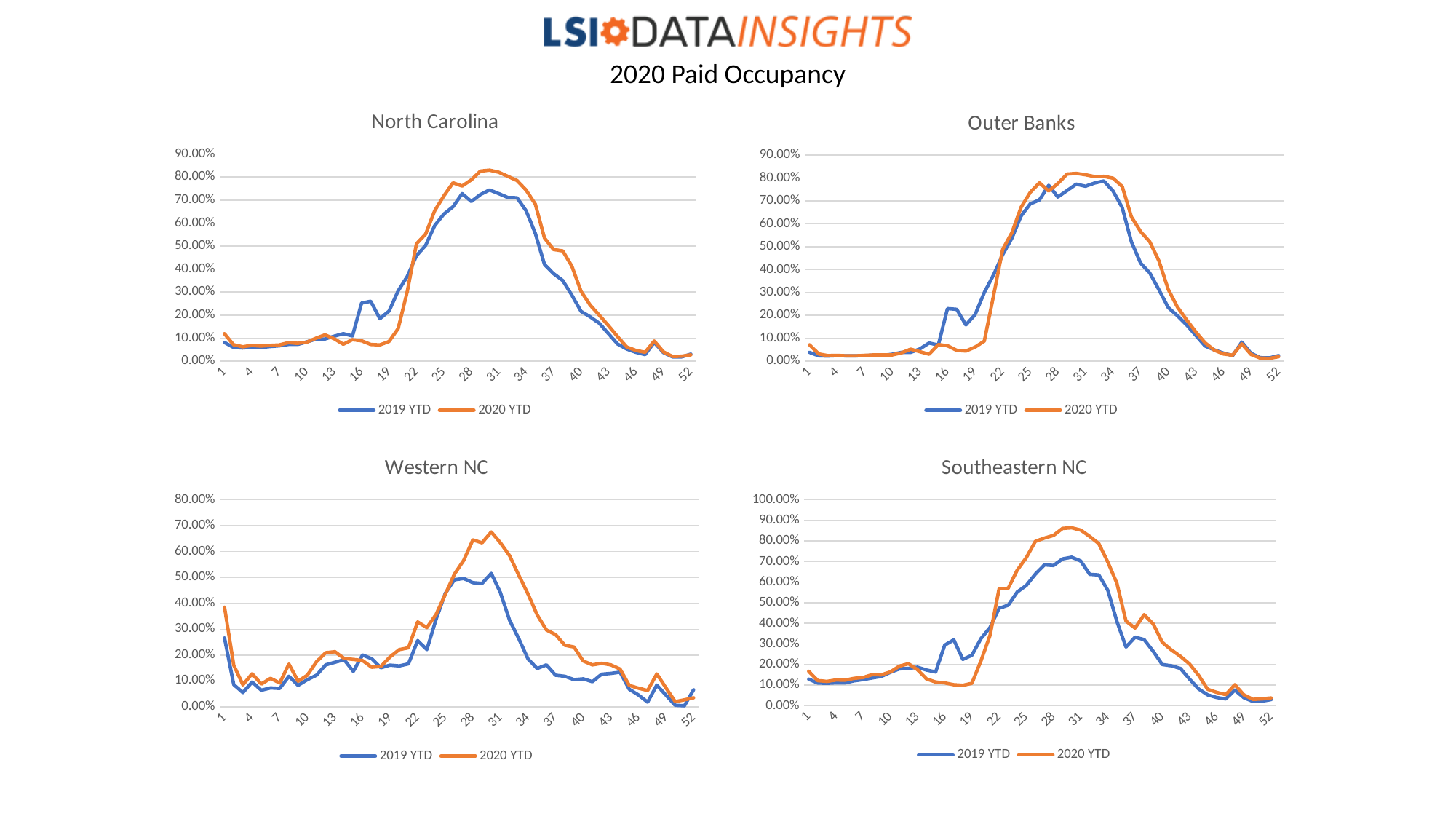
What are the two legend entries on the Western NC chart? 2019 YTD and 2020 YTD What type of chart is the North Carolina chart? line chart How many series does the legend of the Outer Banks chart list? 2 In the Western NC chart, which series is higher at week 31, 2019 YTD or 2020 YTD? 2020 YTD What is the highest value shown on the y axis of the Southeastern NC chart? 100.00% In the Southeastern NC chart, is the 2020 YTD value at week 31 greater or less than 80.00%? greater In the Outer Banks chart, which series is higher at week 37, 2019 YTD or 2020 YTD? 2020 YTD In the Western NC chart, does the 2020 YTD line rise or fall from week 31 to week 40? fall In the Western NC chart, is the 2019 YTD value at week 31 greater or less than 40.00%? greater In the North Carolina chart, is the 2020 YTD value at week 31 greater or less than 70.00%? greater In the North Carolina chart, which series is higher at week 16, 2019 YTD or 2020 YTD? 2019 YTD